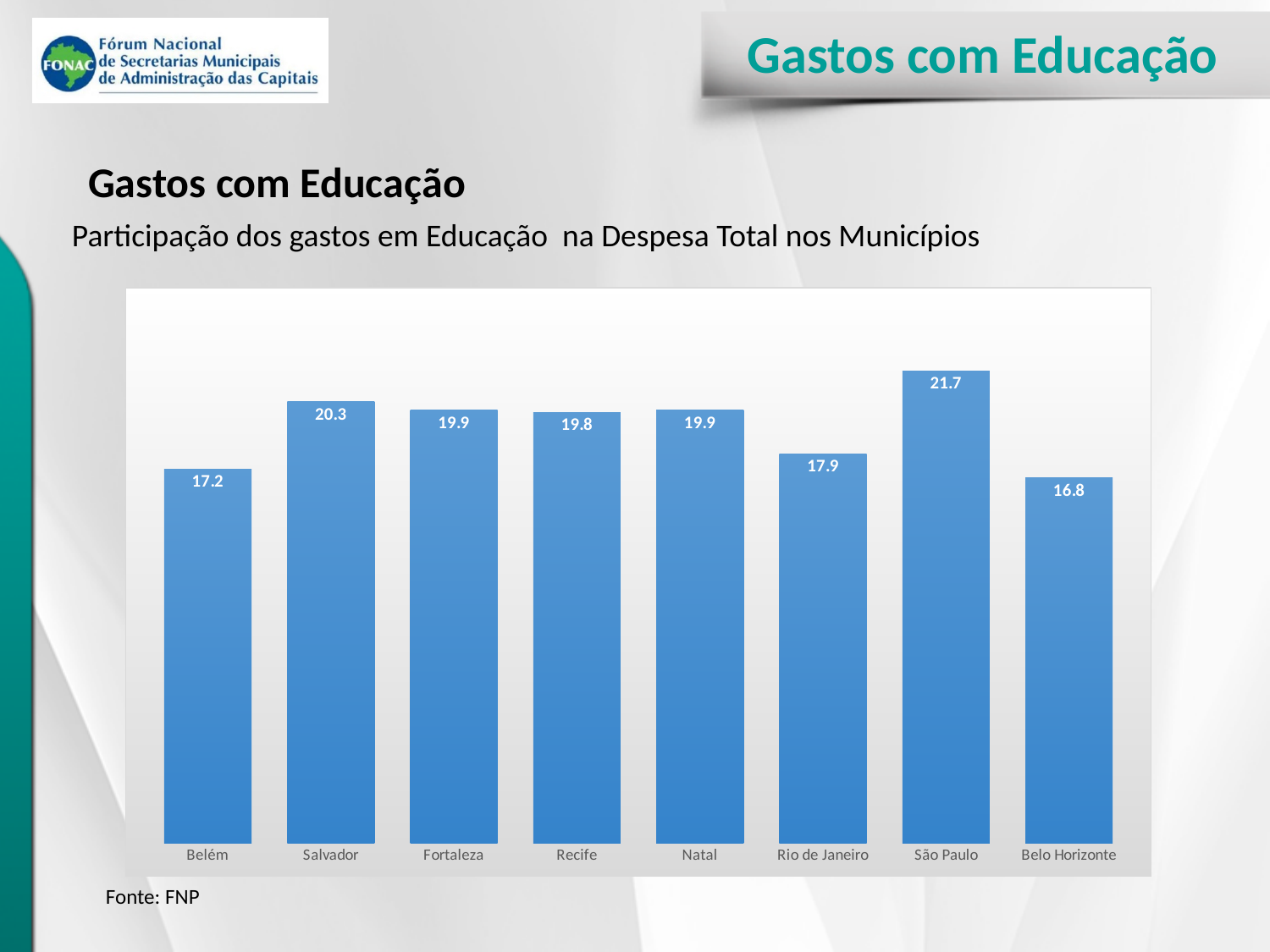
Which city has the highest value? São Paulo What kind of chart is shown on the slide? Bar chart Which is larger, the value for Salvador or the value for Recife? Salvador What is the difference between the values for São Paulo and Belo Horizonte? 4.9 What is the source cited below the chart? FNP What is the value for São Paulo? 21.7 What is the value for Rio de Janeiro? 17.9 How many cities are shown in the chart? 8 What is the difference between the values for Salvador and Belém? 3.1 Which city has the lowest value? Belo Horizonte What is the value for Belém? 17.2 Which is larger, the value for Rio de Janeiro or the value for Belém? Rio de Janeiro